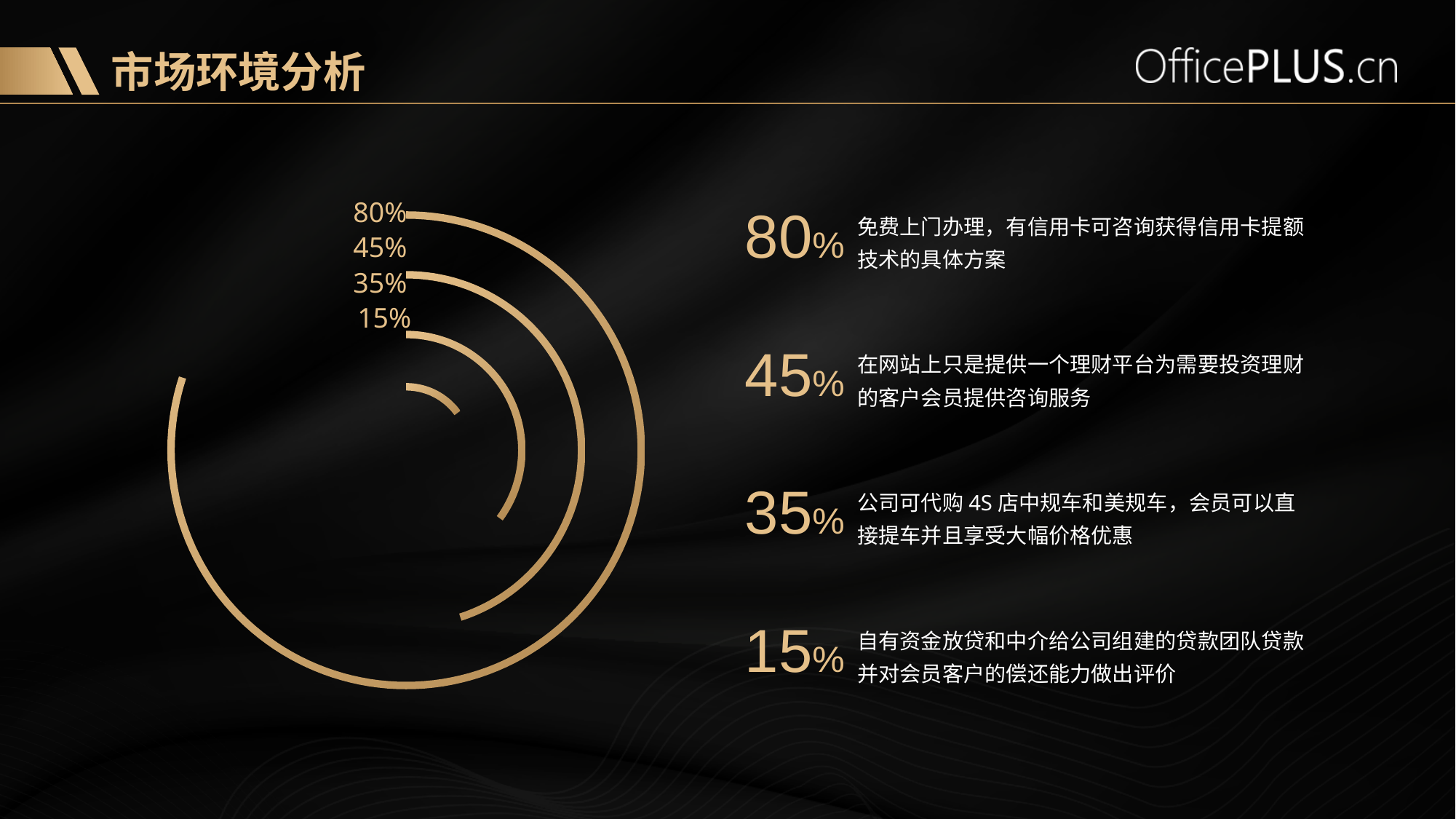
What is the second-largest value shown on the chart? 45% Which value is the highest among the rings on the chart? 80% Which value is the lowest among the rings on the chart? 15% What is the title of the slide containing the chart? 市场环境分析 What value is labelled on the innermost ring of the chart? 15% How many rings (data values) are shown on the chart? 4 What is the difference between the 45% ring and the 35% ring? 10% What value is labelled on the outermost ring of the chart? 80% What kind of chart is shown on the slide? radial bar chart (concentric rings) Which is larger, the value of the outermost ring or the value of the second ring? the outermost ring (80%) What colour are the rings of the chart? gold What is the difference between the largest and smallest values on the chart? 65%